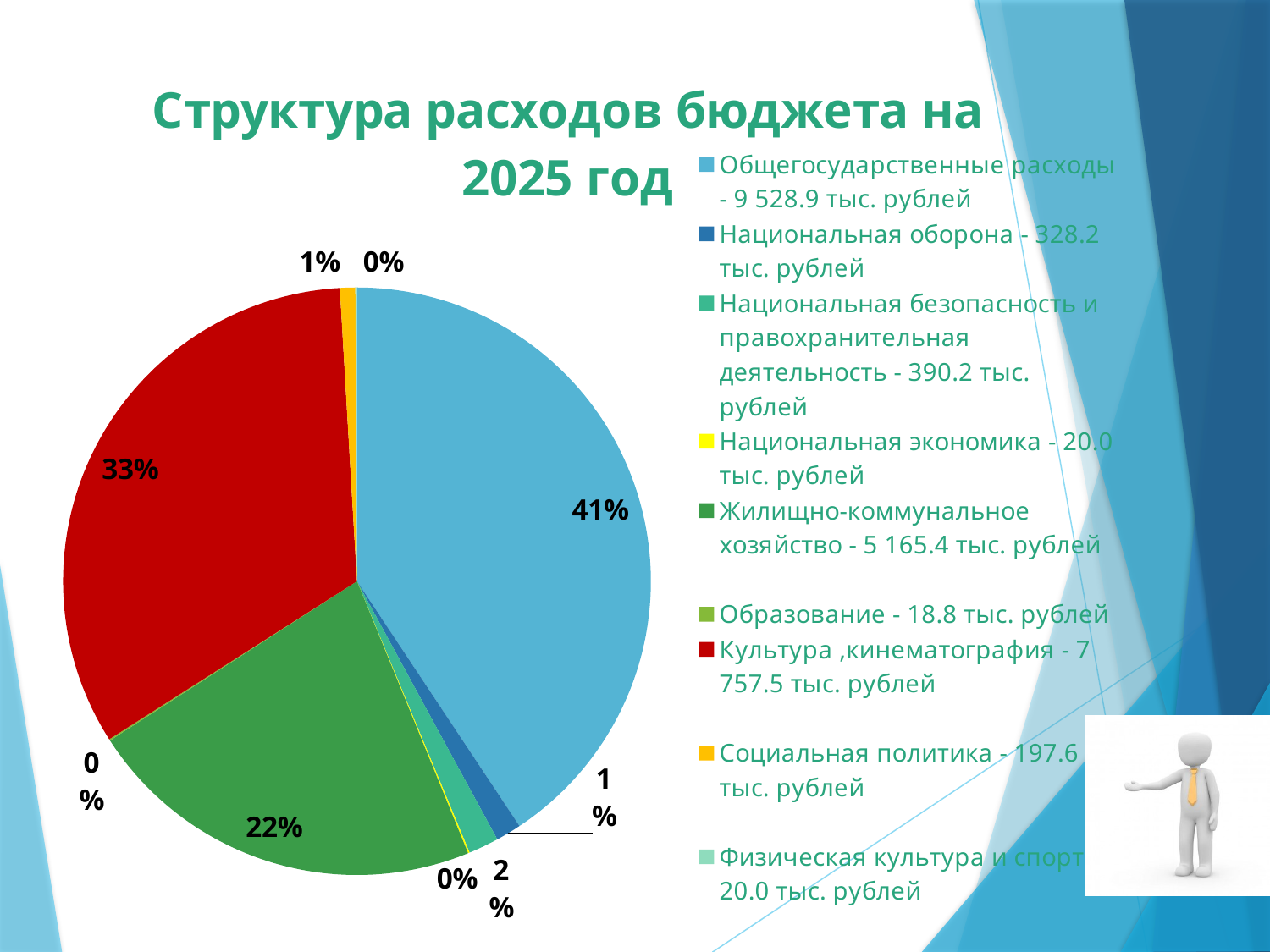
What share of the pie is labelled for Общегосударственные расходы? 41% What colour is the slice for Культура, кинематография? red What kind of chart is shown on the slide? pie chart According to the legend, what amount is given for Национальная оборона? 328.2 тыс. рублей What is the title of the chart? Структура расходов бюджета на 2025 год How many entries does the legend list? 9 According to the legend, what amount is given for Жилищно-коммунальное хозяйство? 5 165.4 тыс. рублей Which is larger: the slice for Культура, кинематография or the slice for Жилищно-коммунальное хозяйство? Культура, кинематография What is the difference in percentage points between the Общегосударственные расходы slice and the Культура, кинематография slice? 8 What share of the pie is labelled for Культура, кинематография? 33% What share of the pie is labelled for Жилищно-коммунальное хозяйство? 22% Which category has the largest slice of the pie? Общегосударственные расходы